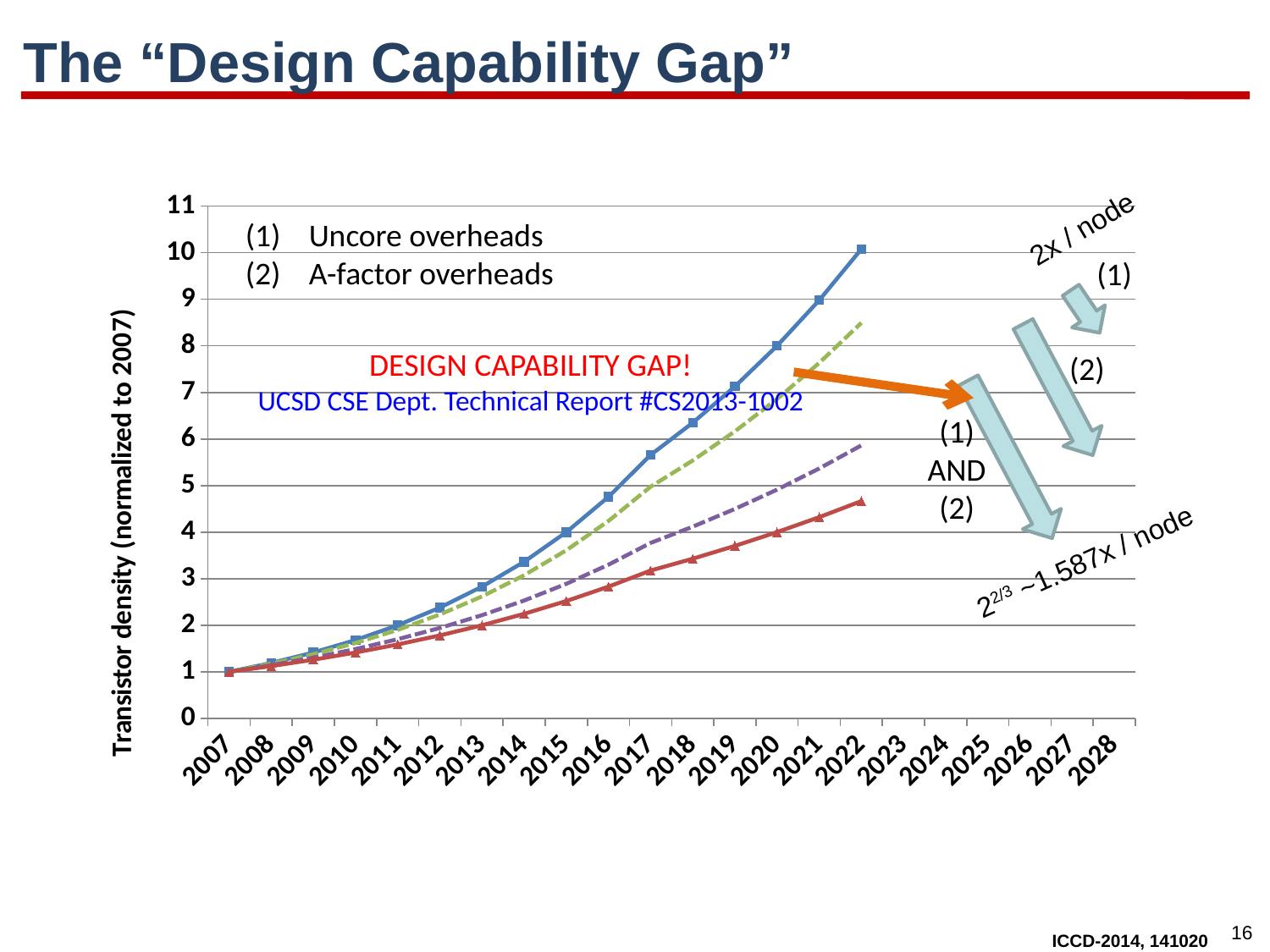
How many years are labelled along the x axis? 22 What is the first year shown on the x axis? 2007 Is the value of the red solid line in 2022 greater or less than 5? less Do the lines rise or fall from 2007 to 2022? rise Which line is lowest in 2022? the red solid line What kind of chart is shown on the slide? line chart Is the value of the blue solid line in 2018 greater or less than 6? greater What is the value of the lines in 2007? 1 What is the label of the vertical axis? Transistor density (normalized to 2007) In 2022, which is larger: the blue solid line or the red solid line? the blue solid line What is the last year shown on the x axis? 2028 Which line is highest in 2022? the blue solid line